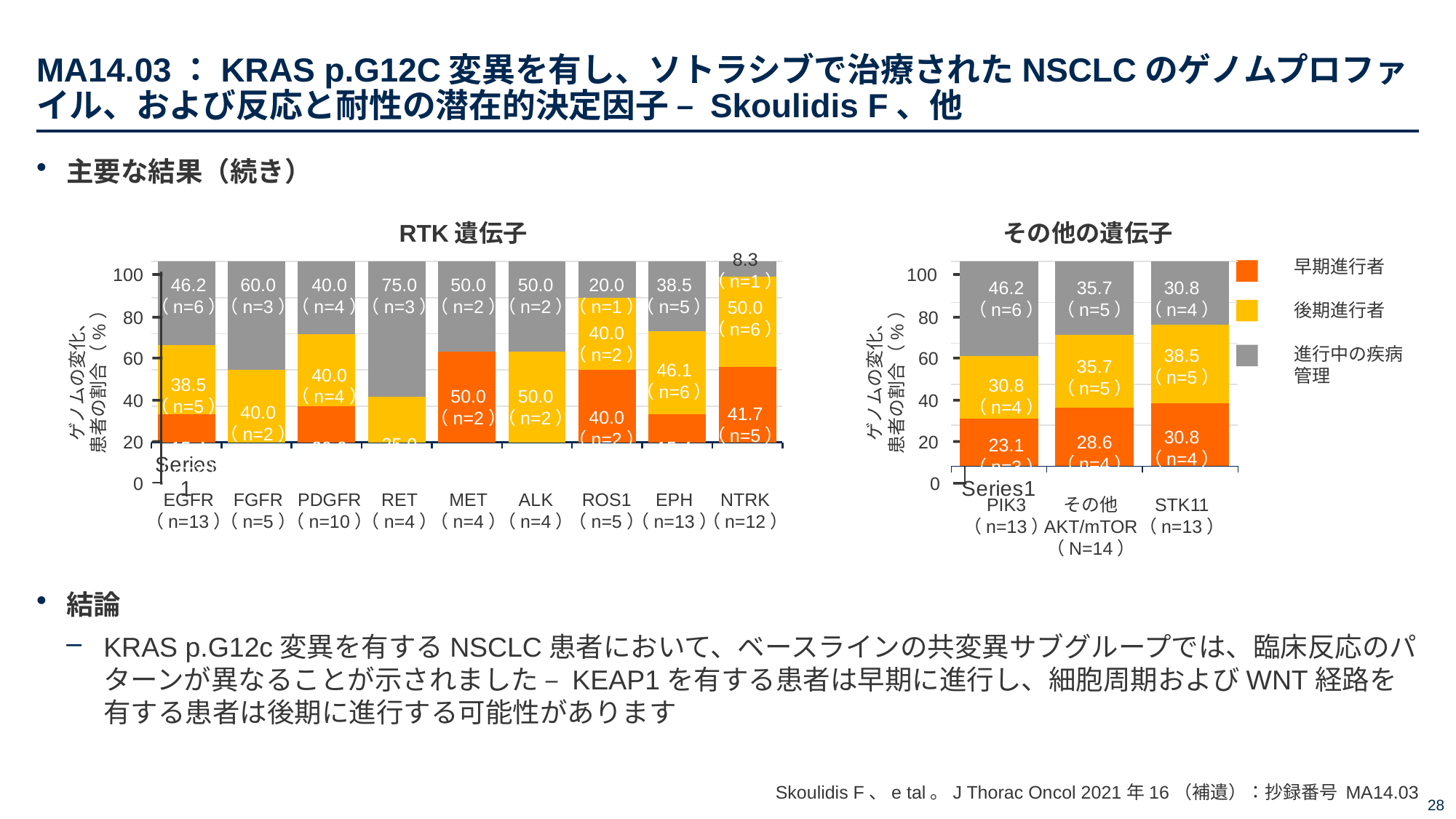
In the その他の遺伝子 chart, what is the 進行中の疾病管理 value for PIK3? 46.2 How many categories are shown on the x axis of the RTK 遺伝子 chart? 9 How many series does the legend list for the その他の遺伝子 chart? 3 What kind of chart is the その他の遺伝子 chart? Stacked bar chart In the RTK 遺伝子 chart, what is the 進行中の疾病管理 value for RET? 75.0 In the RTK 遺伝子 chart, which is larger: the 進行中の疾病管理 value for FGFR or for PDGFR? FGFR In the RTK 遺伝子 chart, what is the 早期進行者 value for NTRK? 41.7 In the RTK 遺伝子 chart, which category has the highest 進行中の疾病管理 value? RET In the RTK 遺伝子 chart, what is the 後期進行者 value for EPH? 46.1 In the その他の遺伝子 chart, what is the difference between the 進行中の疾病管理 values for PIK3 and STK11? 15.4 In the RTK 遺伝子 chart, which category has the lowest 進行中の疾病管理 value? NTRK In the その他の遺伝子 chart, what is the 早期進行者 value for STK11? 30.8